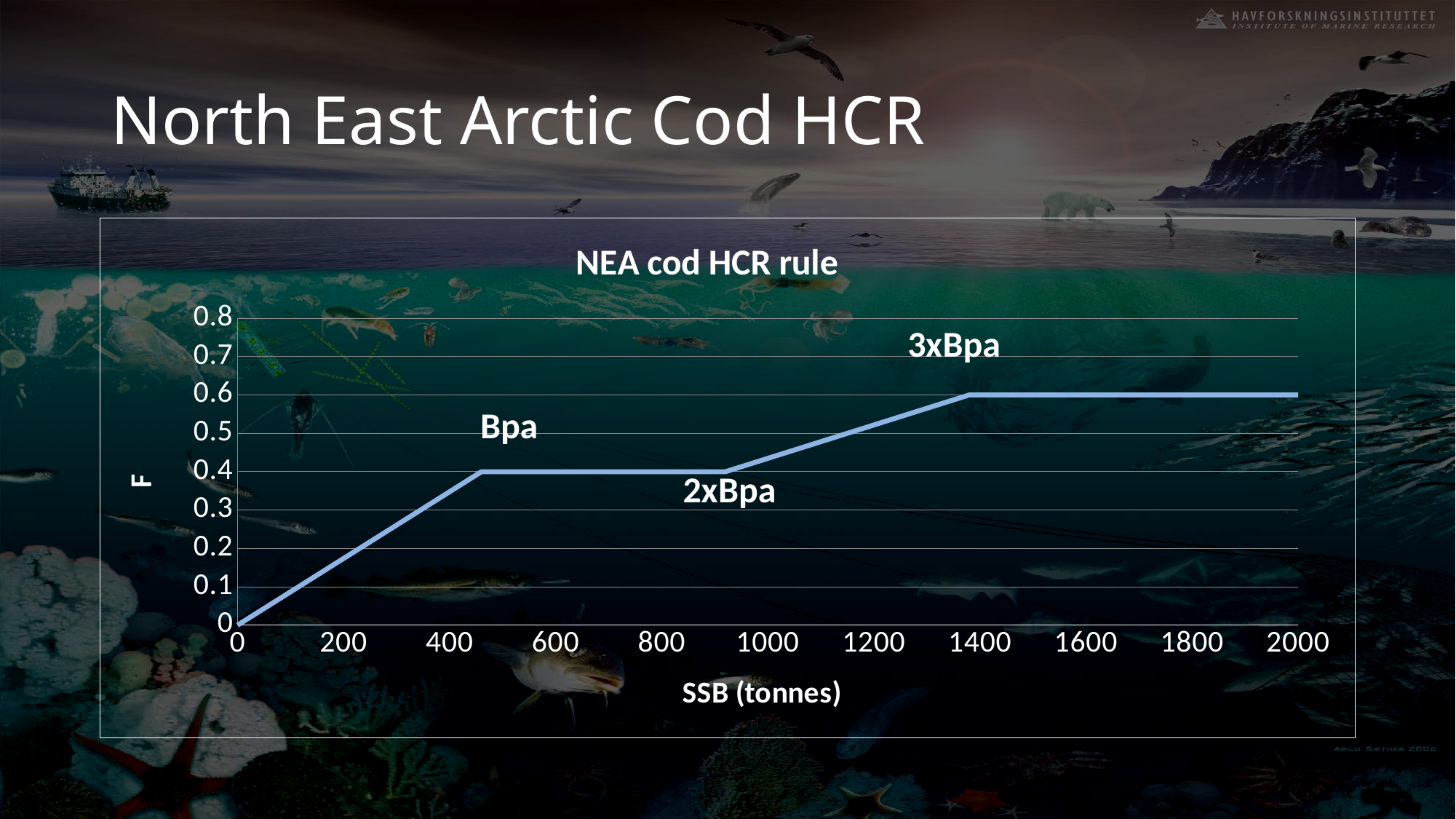
What is the value of F at SSB = 0? 0 What is the title of the chart? NEA cod HCR rule What is the highest value of F reached by the line? 0.6 Is the value of F at SSB = 1000 greater or less than 0.5? less What kind of chart is shown on the slide? line chart Is the value of F at SSB = 600 greater or less than 0.3? greater What value of F does the line reach at the plateau labelled Bpa? 0.4 What is the difference in F between the 3xBpa plateau and the Bpa plateau? 0.2 What value of F does the line reach at the plateau labelled 3xBpa? 0.6 What is the label of the x axis of the chart? SSB (tonnes) Does F rise or fall as SSB increases from 0 to 2000? rise Is the value of F at SSB = 1600 greater or less than 0.5? greater